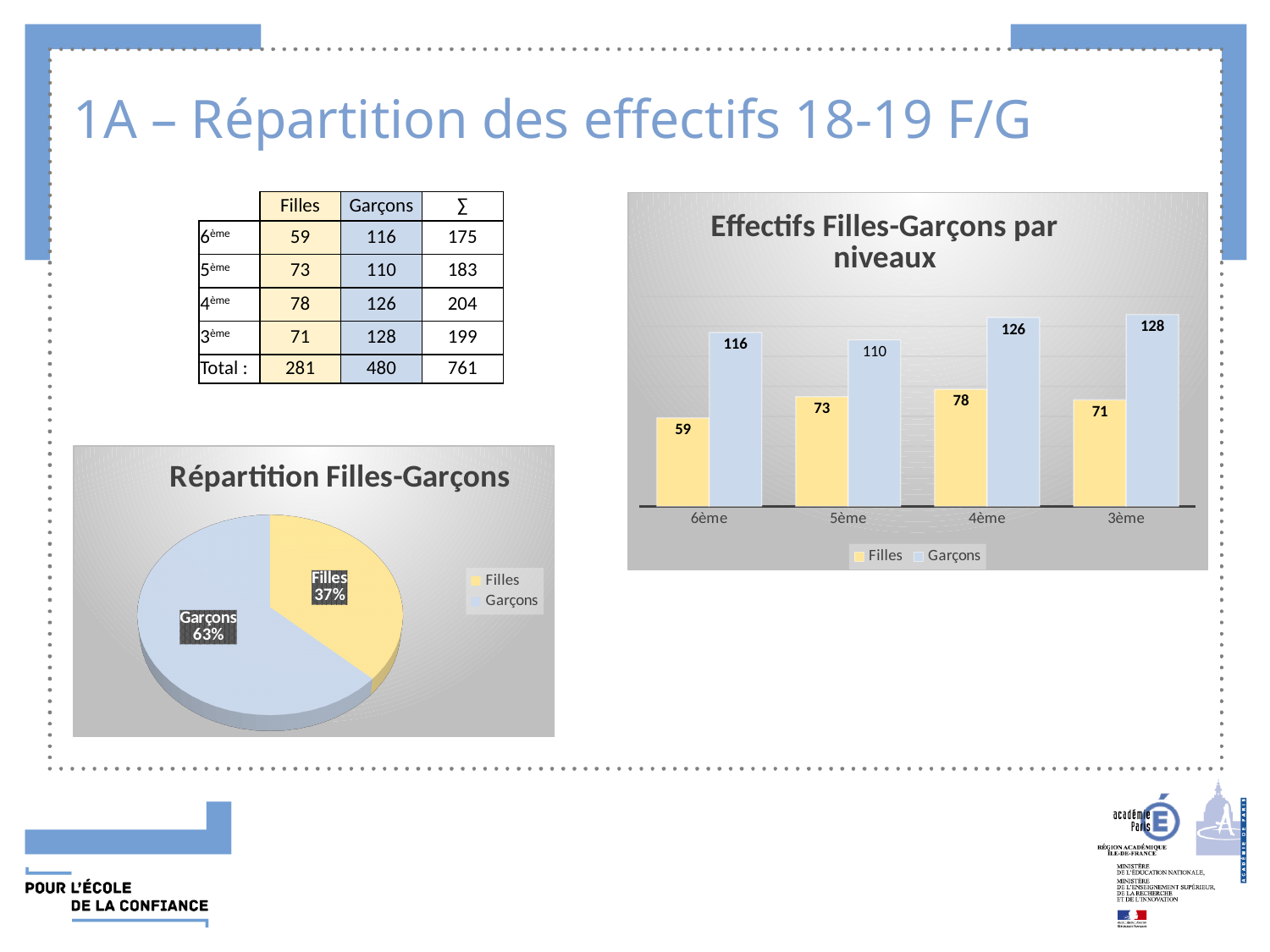
In the chart titled "Effectifs Filles-Garçons par niveaux", what is the value for Garçons in 3ème? 128 In the chart titled "Effectifs Filles-Garçons par niveaux", which is larger: Filles in 5ème or Filles in 3ème? Filles in 5ème In the chart titled "Effectifs Filles-Garçons par niveaux", which level has the highest value for Filles? 4ème In the chart titled "Effectifs Filles-Garçons par niveaux", which level has the lowest value for Garçons? 5ème In the chart titled "Effectifs Filles-Garçons par niveaux", how many series does the legend list? 2 In the chart titled "Effectifs Filles-Garçons par niveaux", what is the value for Garçons in 5ème? 110 What kind of chart is the chart titled "Effectifs Filles-Garçons par niveaux"? Bar chart In the chart titled "Effectifs Filles-Garçons par niveaux", what is the difference between Garçons and Filles in 6ème? 57 What kind of chart is the chart titled "Répartition Filles-Garçons"? Pie chart In the chart titled "Effectifs Filles-Garçons par niveaux", what is the value for Filles in 6ème? 59 In the chart titled "Répartition Filles-Garçons", what share of the pie is Garçons? 63% In the chart titled "Effectifs Filles-Garçons par niveaux", how many levels are shown on the x axis? 4